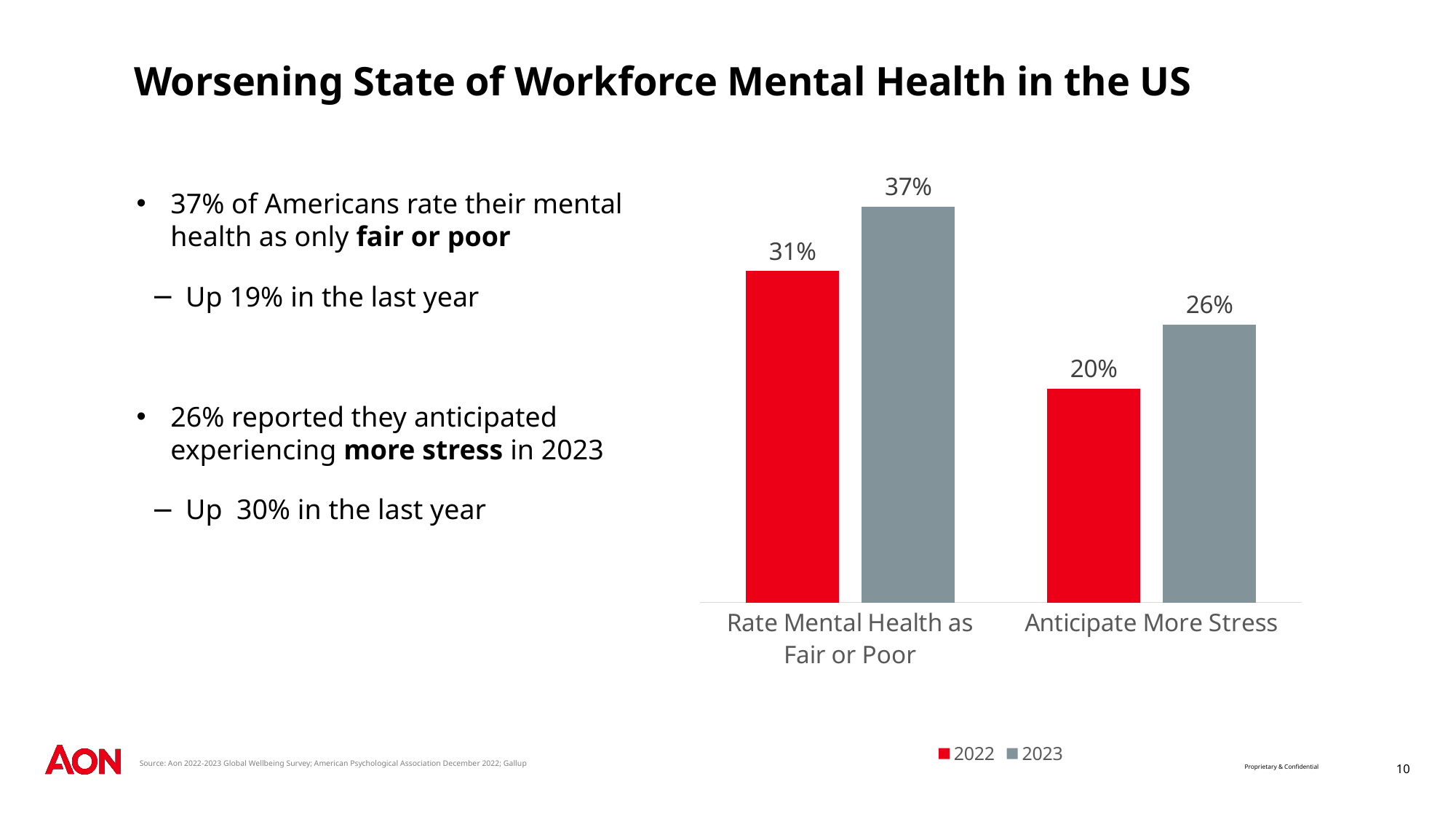
Which category has the lowest 2022 value? Anticipate More Stress What is the 2023 value for Rate Mental Health as Fair or Poor? 37% What is the 2022 value for Rate Mental Health as Fair or Poor? 31% How many categories are shown on the x axis of the chart? 2 What type of chart is shown on the slide? Bar chart Which is larger: the 2022 value for Rate Mental Health as Fair or Poor or the 2023 value for Anticipate More Stress? 2022 value for Rate Mental Health as Fair or Poor Which category has the highest 2023 value? Rate Mental Health as Fair or Poor What is the 2022 value for Anticipate More Stress? 20% What is the 2023 value for Anticipate More Stress? 26% What is the difference between the 2023 and 2022 values for Anticipate More Stress? 6% How many series does the chart legend list? 2 What is the difference between the 2023 and 2022 values for Rate Mental Health as Fair or Poor? 6%